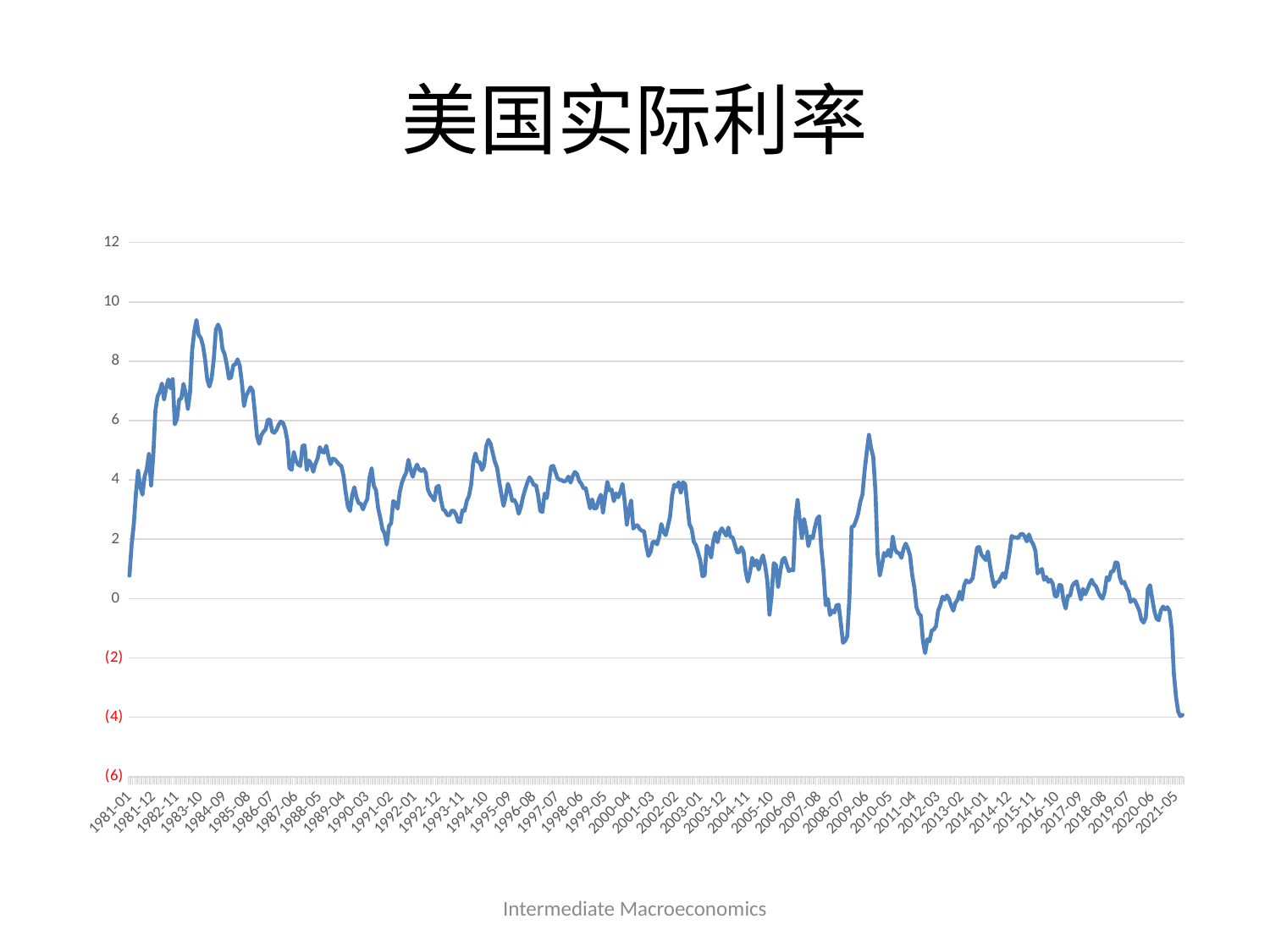
Which is larger, the value at 1984-09 or the value at 2021-05? 1984-09 Is the value at 1984-09 greater or less than 6? greater What is the last date label on the horizontal axis? 2021-05 Is the value at 2012-03 greater or less than 2? less What is the title of the chart? 美国实际利率 Is the value at 2021-05 greater or less than (2)? less What kind of chart is shown on the slide? line chart What is the highest value shown on the vertical axis? 12 What is the first date label on the horizontal axis? 1981-01 Overall, do the values rise or fall from 1981-01 to 2021-05? fall